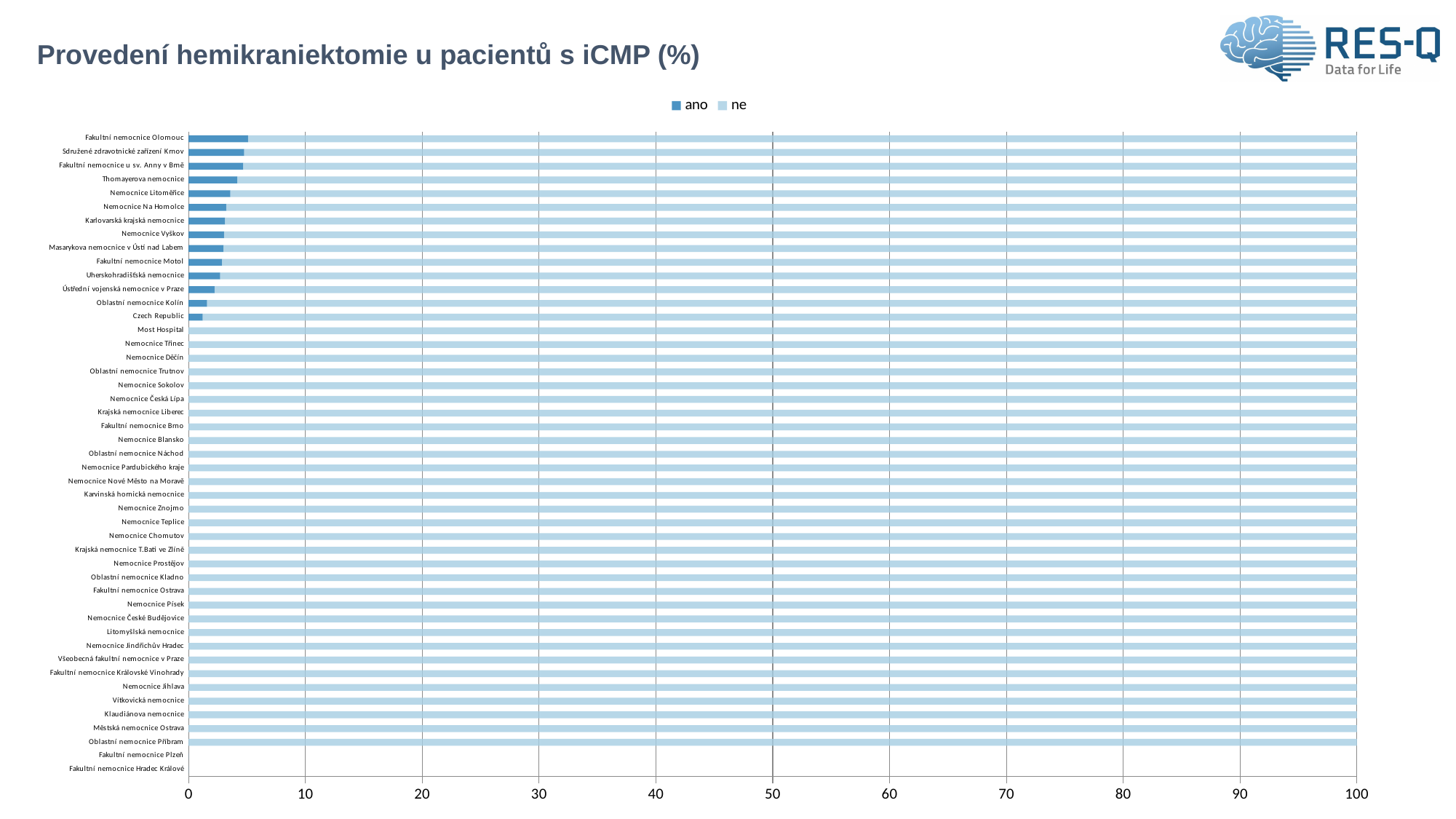
Which has a larger 'ano' value: Fakultní nemocnice Olomouc or Czech Republic? Fakultní nemocnice Olomouc Is the 'ano' value for Fakultní nemocnice Olomouc greater or less than 10? less Which hospital has the highest value for the 'ano' series? Fakultní nemocnice Olomouc What are the two series named in the legend? ano, ne What is the title of the chart? Provedení hemikraniektomie u pacientů s iCMP (%) Which two hospitals at the bottom of the chart have no bar plotted at all? Fakultní nemocnice Plzeň and Fakultní nemocnice Hradec Králové How many categories show a visible 'ano' segment? 14 Is the 'ne' value for Nemocnice Třinec greater or less than 90? greater What kind of chart is shown on the slide? Stacked bar chart How many series does the legend list? 2 How many categories are listed on the vertical axis of the chart? 47 Which has a larger 'ano' value: Czech Republic or Oblastní nemocnice Kolín? Oblastní nemocnice Kolín